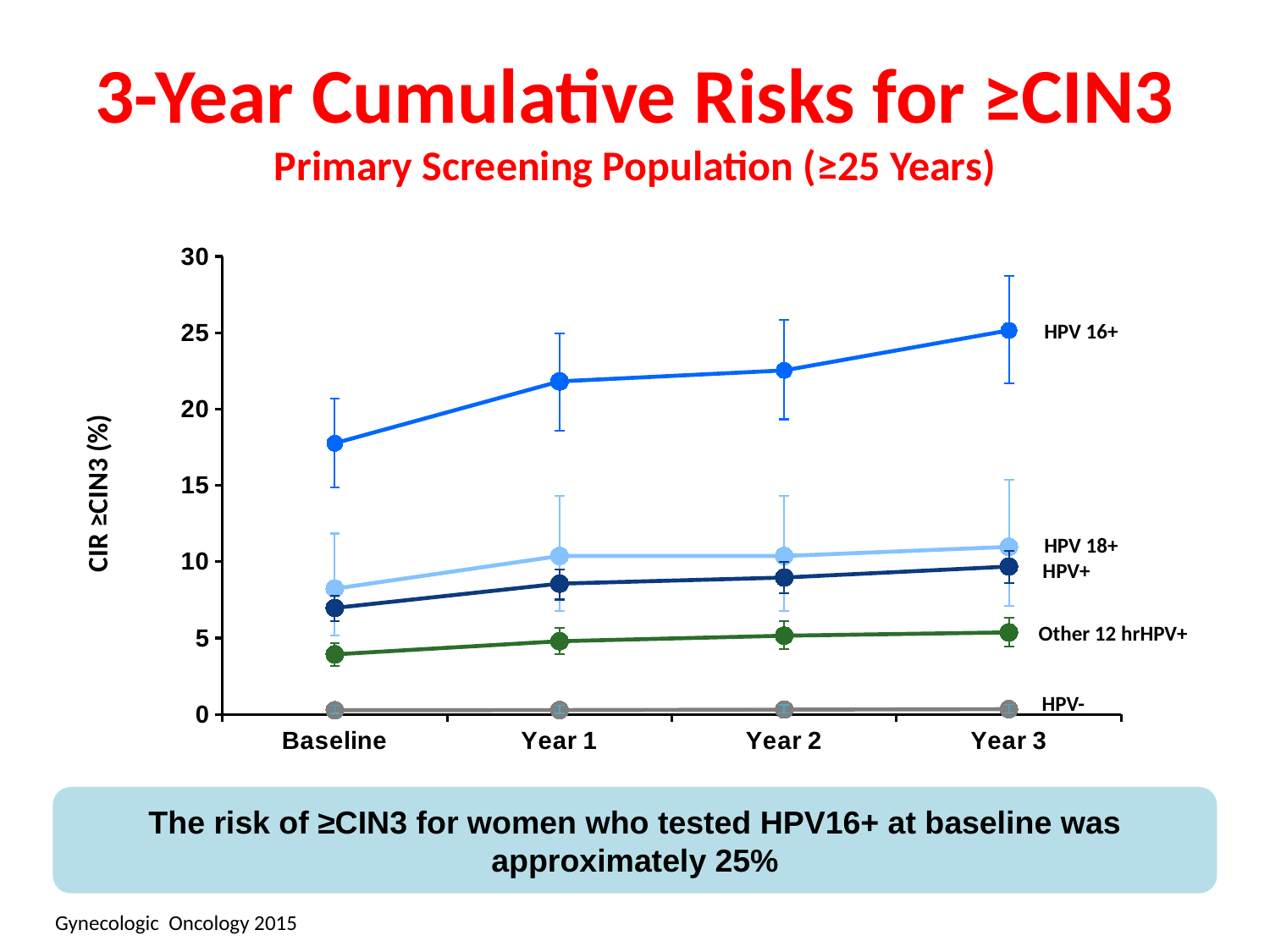
Which series has the highest value at Year 3? HPV 16+ Is the value for HPV 16+ at Year 3 greater or less than 20? greater Is the value for HPV+ at Baseline greater or less than 10? less Does the HPV 16+ series rise or fall from Baseline to Year 3? rise How many time points are plotted along the x axis? 4 At Year 2, which is larger: the value for HPV 16+ or the value for HPV+? HPV 16+ What is the label on the y axis? CIR ≥CIN3 (%) Is the value for HPV 16+ at Baseline greater or less than 20? less Which series has the lowest value at Baseline? HPV- What kind of chart is shown on the slide? line chart How many series are labelled on the chart? 5